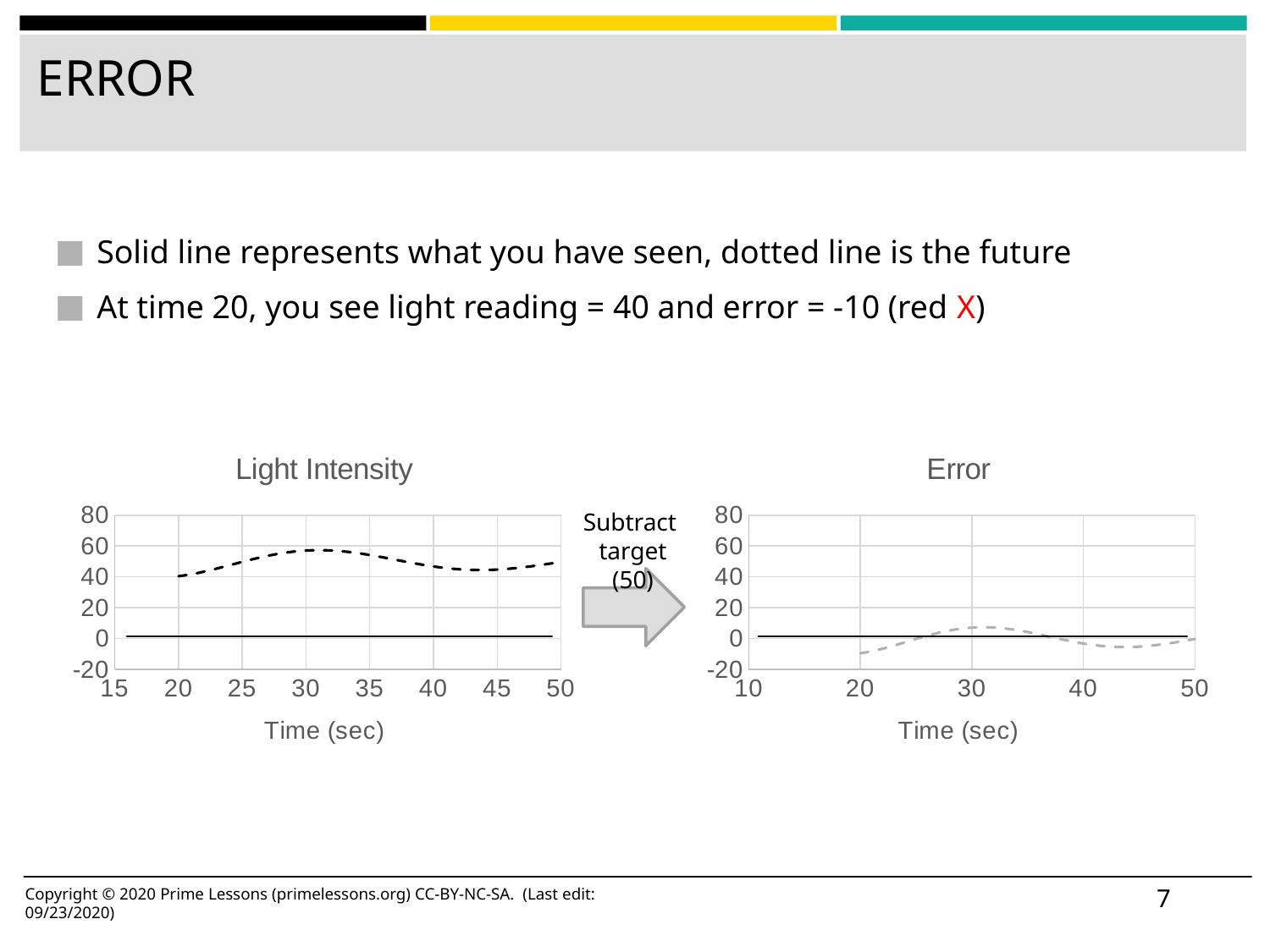
In the Error chart, is the value at time 45 greater or less than 0? less What kind of chart is the Error chart? line chart In the Light Intensity chart, does the dotted line rise or fall between time 20 and time 30? rise In the Light Intensity chart, what is the light reading at time 20? 40 In the Error chart, what is the error value at time 20? -10 In the Light Intensity chart, is the value at time 30 greater or less than 40? greater In the Light Intensity chart, is the value at time 30 greater or less than 60? less What kind of chart is the Light Intensity chart? line chart In the Error chart, does the dotted line rise or fall between time 30 and time 45? fall What is the x-axis label on the Error chart? Time (sec)